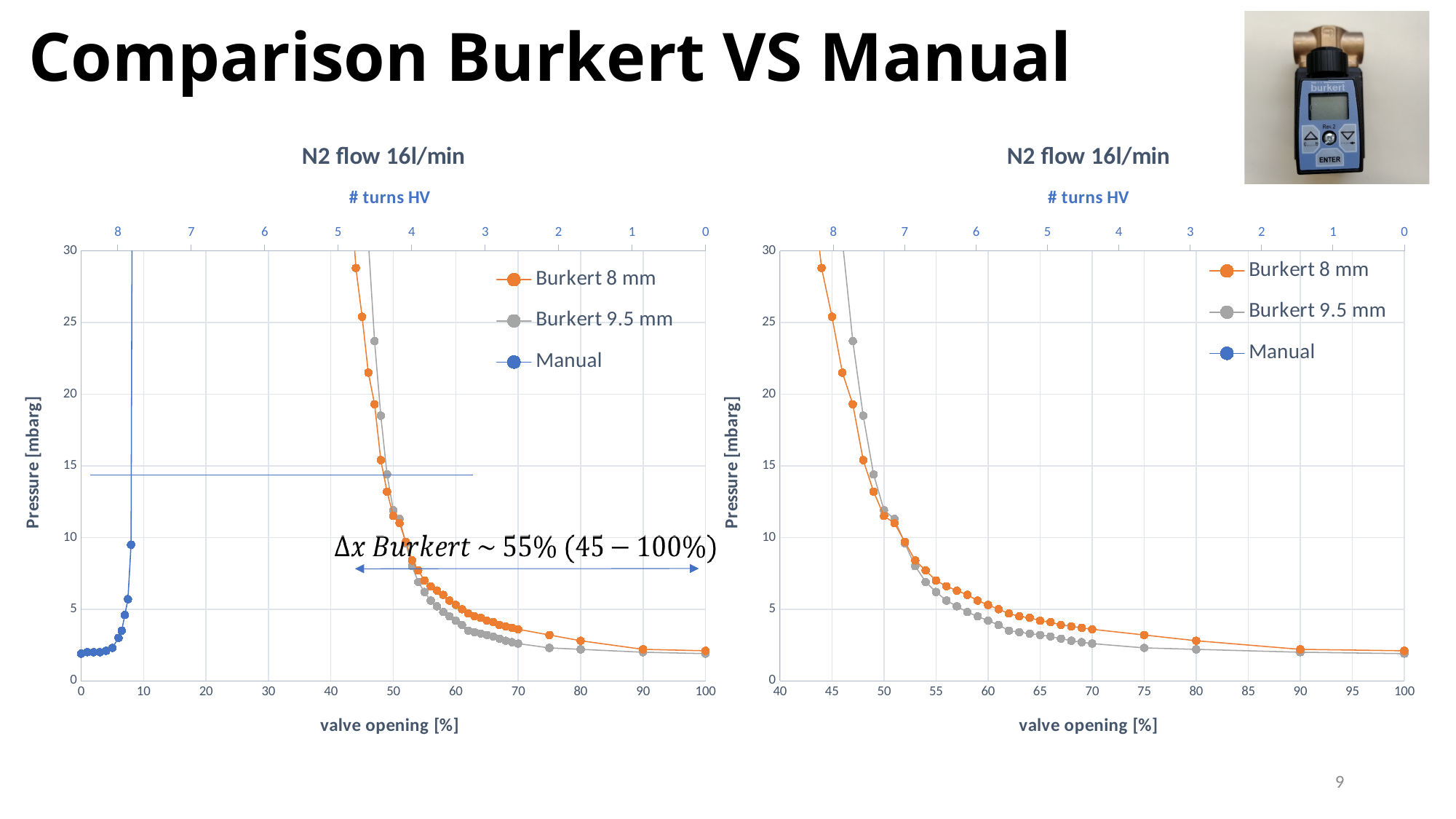
In the right chart, is the pressure for Burkert 9.5 mm at 47% valve opening greater or less than 20? greater In the left chart, is the pressure for Burkert 8 mm at 100% valve opening greater or less than 5? less In the left chart, is the highest plotted pressure for Burkert 8 mm greater or less than 25? greater In the right chart, at 60% valve opening, which series shows the higher pressure: Burkert 8 mm or Burkert 9.5 mm? Burkert 8 mm In the right chart, at 47% valve opening, which series shows the higher pressure: Burkert 8 mm or Burkert 9.5 mm? Burkert 9.5 mm How many series does the legend of the right chart list? 3 What type of chart is the left chart titled 'N2 flow 16l/min'? line chart In the right chart, does the pressure for Burkert 8 mm rise or fall as valve opening increases? fall In the left chart, what is the label of the vertical axis? Pressure [mbarg] In the right chart, what is the title of the secondary (top) horizontal axis? # turns HV